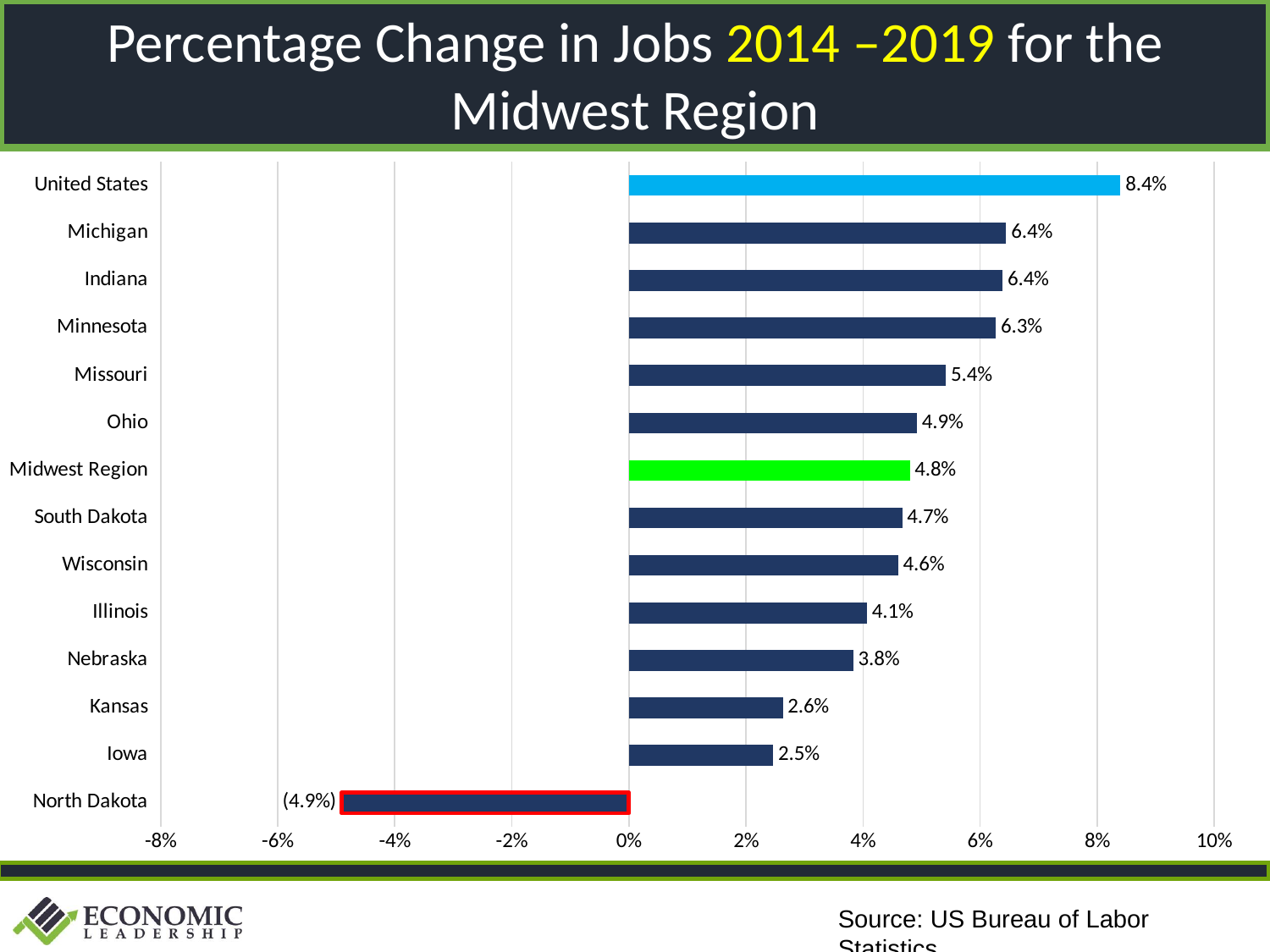
Which category has the lowest percentage change in jobs? North Dakota Is the value for Nebraska greater or less than 4%? less How many categories are shown on the chart? 14 Which category has the highest percentage change in jobs? United States What kind of chart is shown on the slide? Bar chart Which has a larger percentage change in jobs, Ohio or Illinois? Ohio What is the difference between the United States value and the Midwest Region value? 3.6% Which bar is coloured bright green? Midwest Region What is the percentage change in jobs for Missouri? 5.4% What is the percentage change in jobs for the Midwest Region? 4.8% What is the value shown for North Dakota? (4.9%) What is the title of the chart? Percentage Change in Jobs 2014 –2019 for the Midwest Region